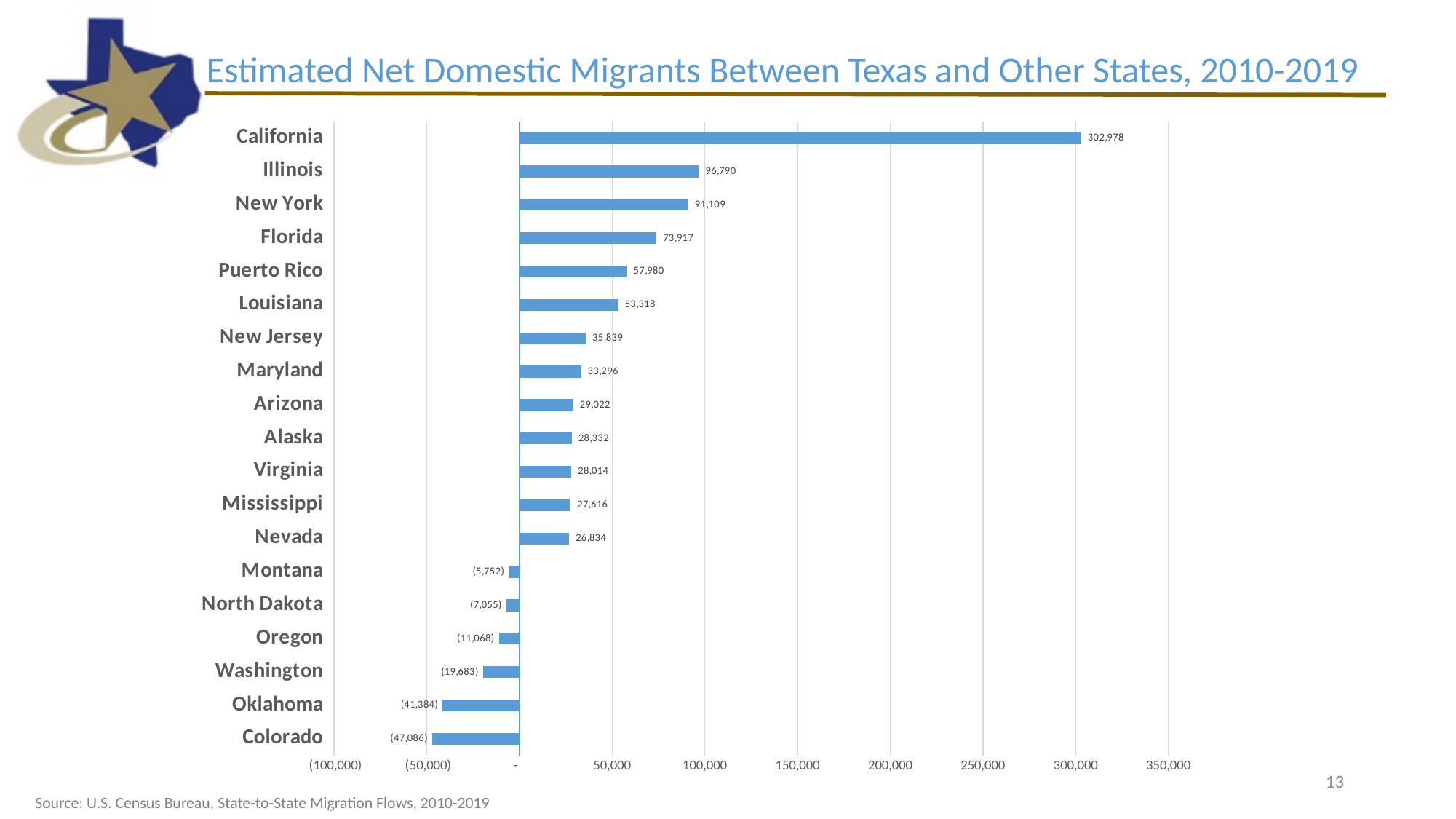
What is the value shown for Illinois? 96,790 What kind of chart is shown on the slide? Bar chart What is the title of the chart? Estimated Net Domestic Migrants Between Texas and Other States, 2010-2019 Which has a larger value, Florida or Louisiana? Florida Which state has the lowest net domestic migration value? Colorado What is the estimated net domestic migration value for California? 302,978 How many states or territories are shown in the chart? 19 What is the value shown for Puerto Rico? 57,980 Which state has the highest net domestic migration value? California Is the value for New York greater or less than 100,000? less What is the value shown for Colorado? (47,086) What is the difference between the values for Illinois and New York? 5,681